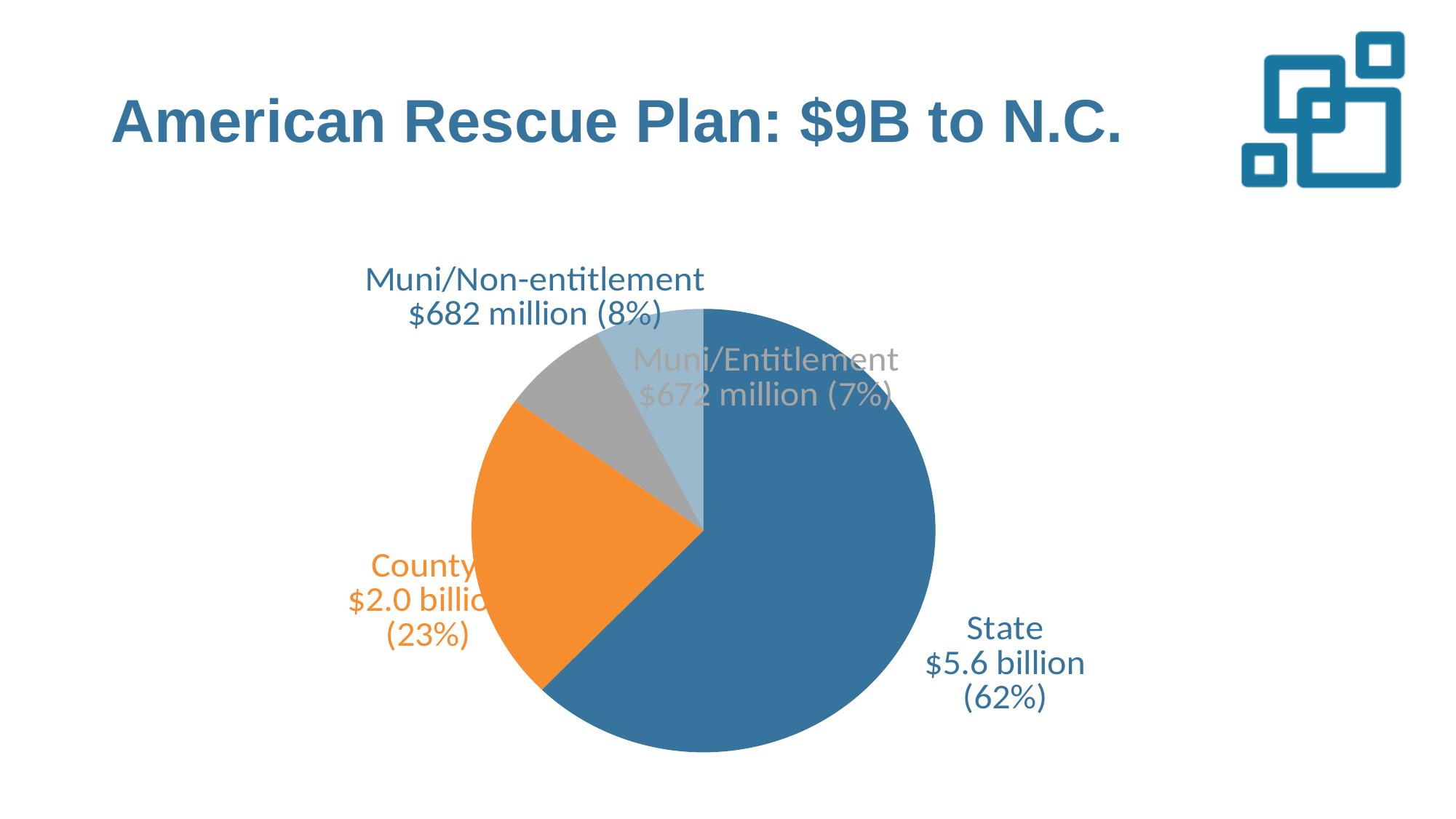
What dollar amount is shown for the Muni/Non-entitlement slice? $682 million What is the difference in percentage points between the State share and the County share? 39% What is the title of the slide? American Rescue Plan: $9B to N.C. What share of the pie does the State slice represent? 62% What share of the pie does the County slice represent? 23% Which slice of the pie chart is the largest? State What type of chart is shown on the slide? Pie chart What dollar amount is shown for the State slice? $5.6 billion Which slice of the pie chart is the smallest? Muni/Entitlement What dollar amount is shown for the Muni/Entitlement slice? $672 million How many slices does the pie chart have? 4 What dollar amount is shown for the County slice? $2.0 billion